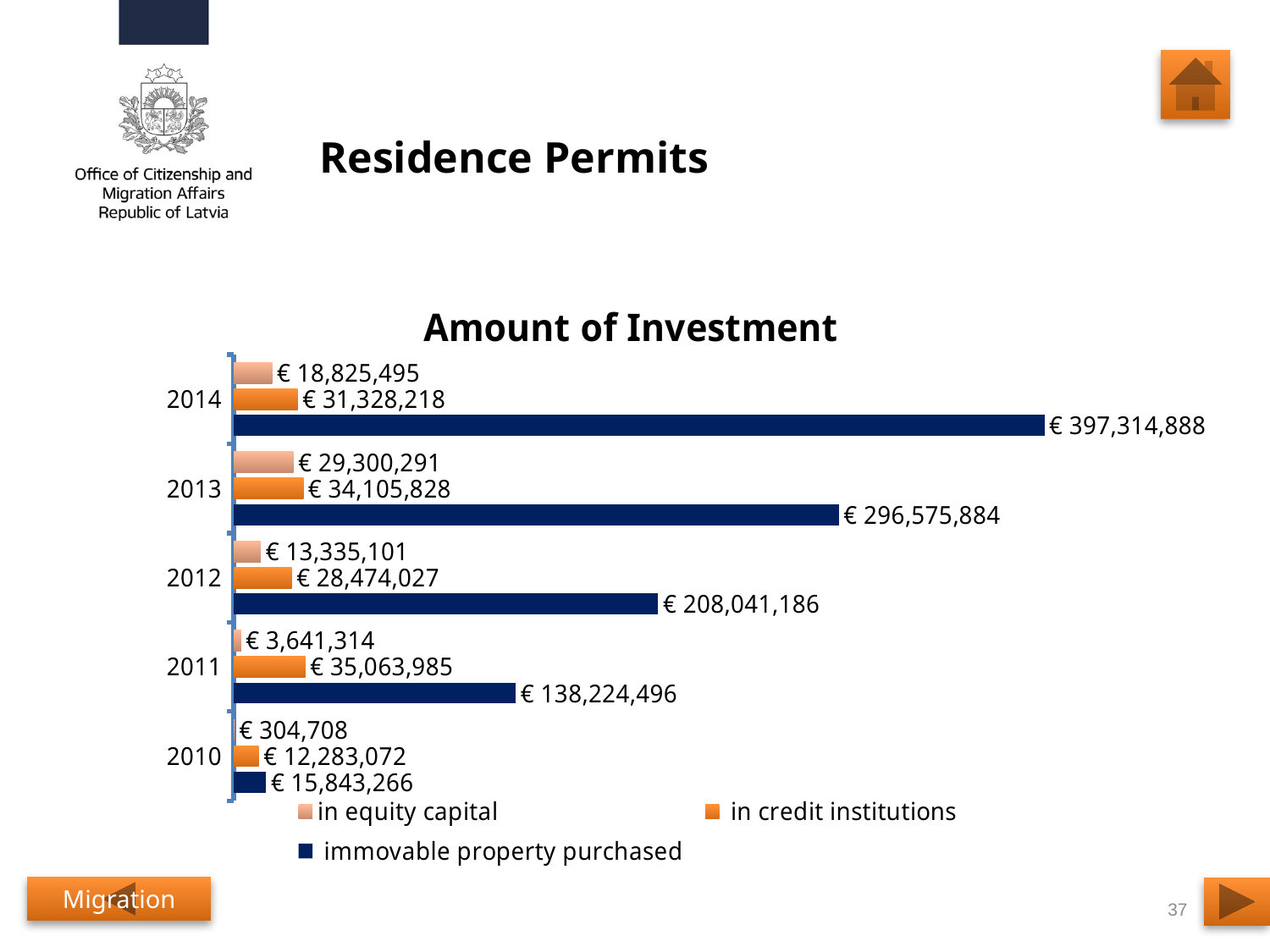
How many series does the legend list? 3 Which year has the highest value for immovable property purchased? 2014 What is the value for in equity capital in 2010? € 304,708 What is the difference between the immovable property purchased values for 2014 and 2013? € 100,739,004 How many years are shown on the chart? 5 What kind of chart is shown? bar chart Which is larger in 2013: in equity capital or in credit institutions? in credit institutions Does the value for immovable property purchased rise or fall from 2010 to 2014? rise What is the value for immovable property purchased in 2014? € 397,314,888 What is the value for in credit institutions in 2012? € 28,474,027 What is the difference between the in credit institutions values for 2011 and 2010? € 22,780,913 Which year has the lowest value for in equity capital? 2010